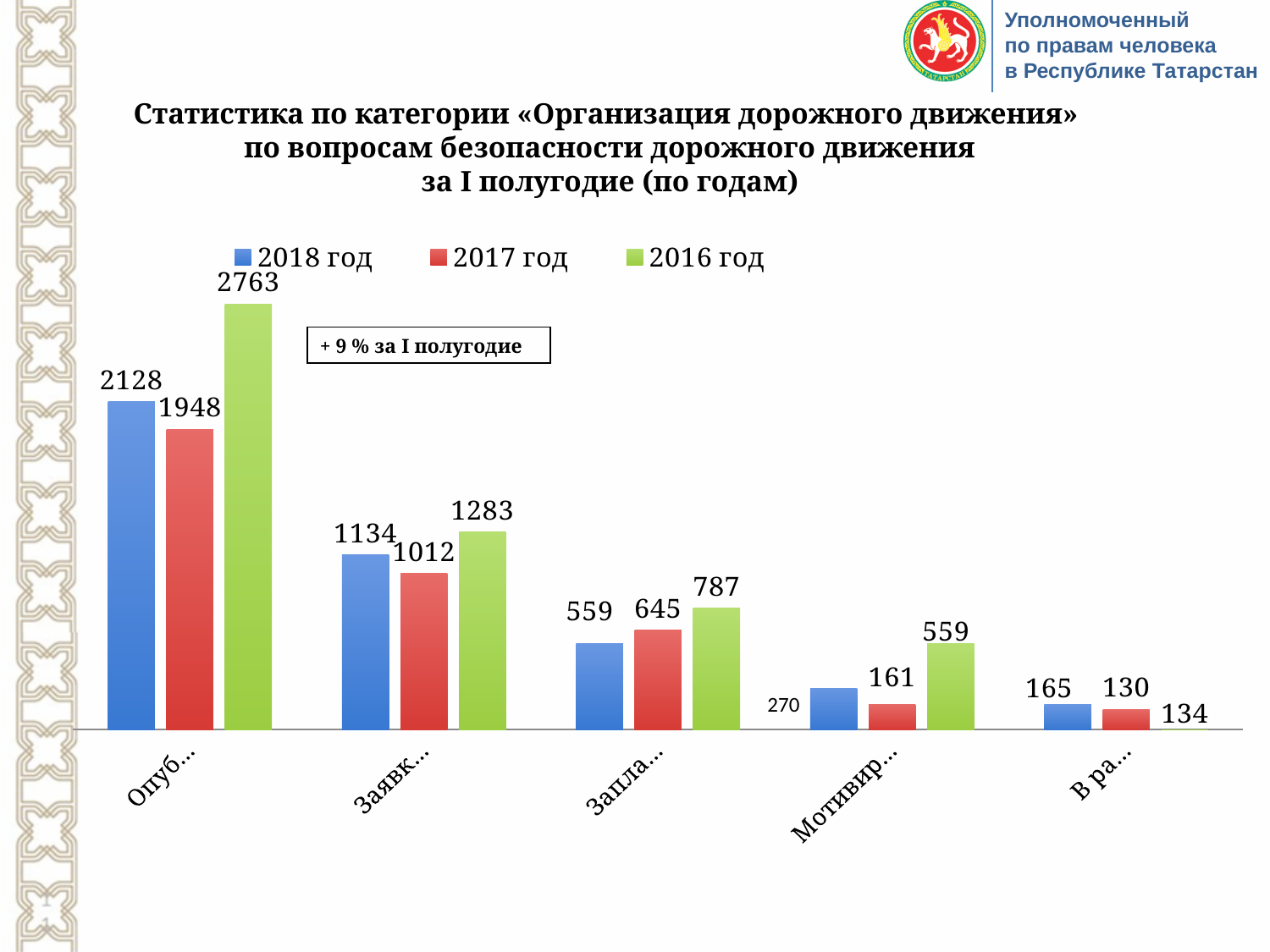
What is the value of the 2018 год series for the fifth category from the left (В ра...)? 165 What is the value of the 2018 год series for the second category from the left (Заявк...)? 1134 What text is shown in the boxed annotation on the chart? + 9 % за I полугодие Which series has the highest value for the first category from the left (Опуб...)? 2016 год What is the difference between the 2018 год and 2017 год values for the first category from the left (Опуб...)? 180 For the third category from the left (Запла...), which is larger: the 2018 год value or the 2016 год value? 2016 год Which series has the lowest value for the fourth category from the left (Мотивир...)? 2017 год What is the value of the 2016 год series for the first category from the left (Опуб...)? 2763 What is the value of the 2017 год series for the third category from the left (Запла...)? 645 What kind of chart is shown on the slide? bar chart How many series does the legend list? 3 How many categories are shown along the x axis? 5